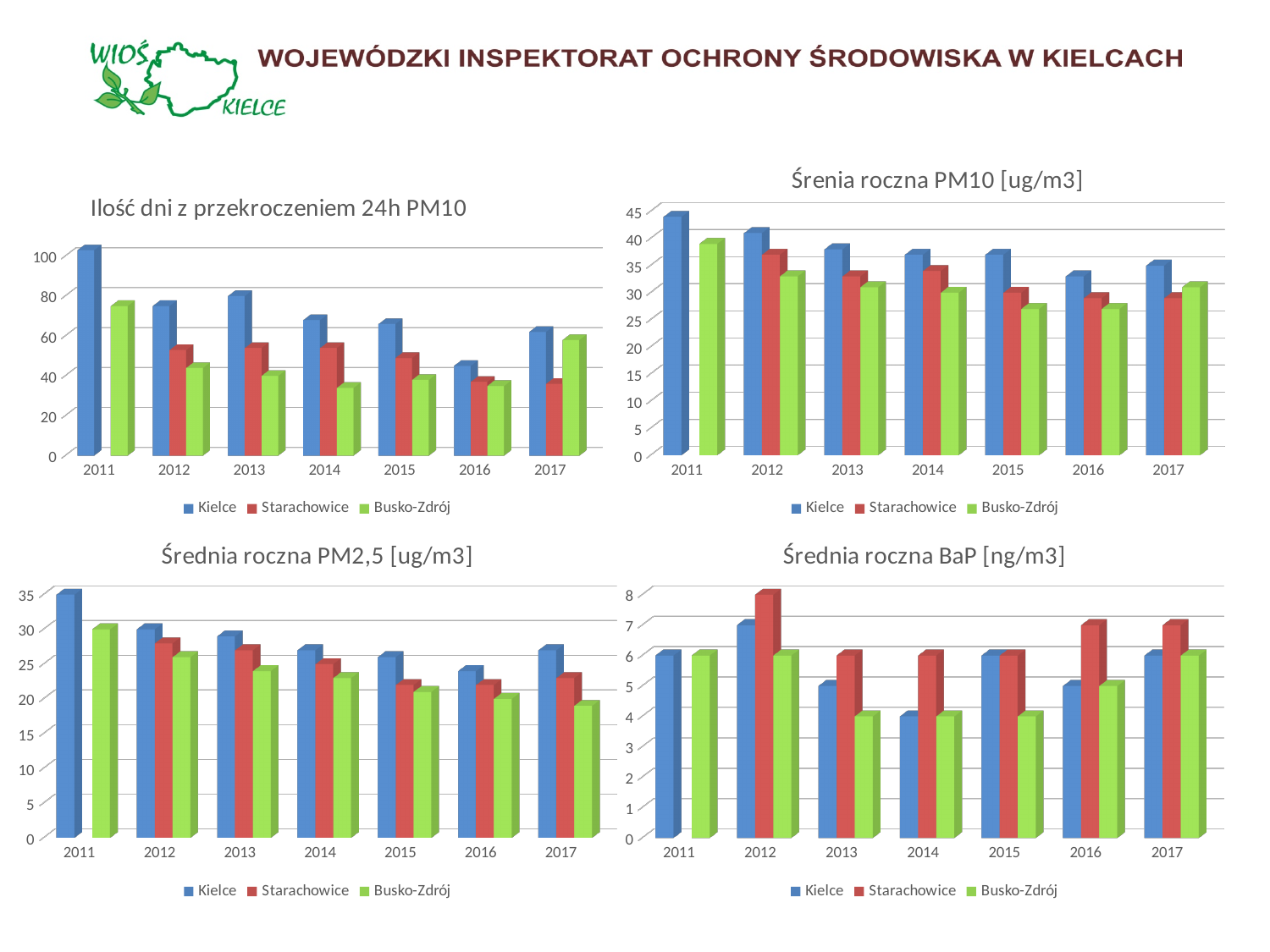
In the 'Ilość dni z przekroczeniem 24h PM10' chart, is the value for Kielce in 2011 greater or less than 100? greater How many years are shown on the x axis of the 'Śrenia roczna PM10 [ug/m3]' chart? 7 In the 'Śrenia roczna PM10 [ug/m3]' chart, is the value for Kielce in 2011 greater or less than 40? greater In the 'Średnia roczna PM2,5 [ug/m3]' chart, do the Busko-Zdrój values rise or fall from 2012 to 2017? fall In the 'Średnia roczna BaP [ng/m3]' chart, what is the value for Starachowice in 2012? 8 How many series does the legend of the 'Ilość dni z przekroczeniem 24h PM10' chart list? 3 In the 'Średnia roczna BaP [ng/m3]' chart, which series has the highest bar in 2012? Starachowice In the 'Śrenia roczna PM10 [ug/m3]' chart, do the Kielce values generally rise or fall from 2011 to 2016? fall In the 'Ilość dni z przekroczeniem 24h PM10' chart, which is larger in 2017: Kielce or Starachowice? Kielce In the 'Ilość dni z przekroczeniem 24h PM10' chart, which year has the highest Kielce bar? 2011 In the 'Średnia roczna PM2,5 [ug/m3]' chart, is the value for Kielce in 2011 greater or less than 30? greater What kind of chart is the 'Średnia roczna BaP [ng/m3]' chart? bar chart